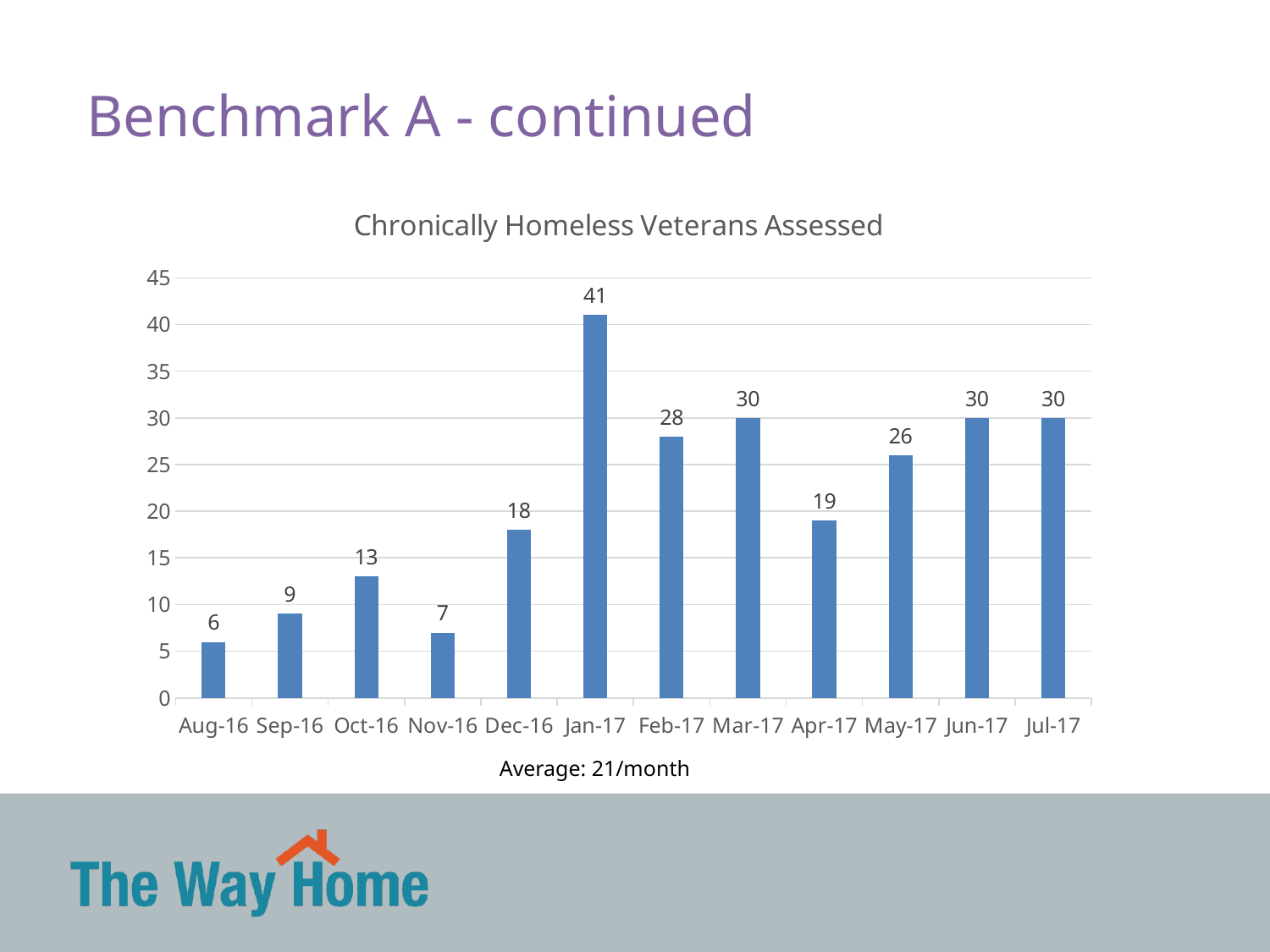
How many months are shown on the x axis? 12 Which month has the highest value? Jan-17 Which is larger, the value for Dec-16 or the value for Apr-17? Apr-17 What is the value for Aug-16? 6 What is the difference between the values for Jan-17 and Feb-17? 13 What is the value for Jan-17? 41 What is the value for Apr-17? 19 What kind of chart is shown? bar chart What is the title of the chart? Chronically Homeless Veterans Assessed Is the value for May-17 greater or less than 25? greater Do the values rise or fall from Aug-16 to Oct-16? rise Which month has the lowest value? Aug-16